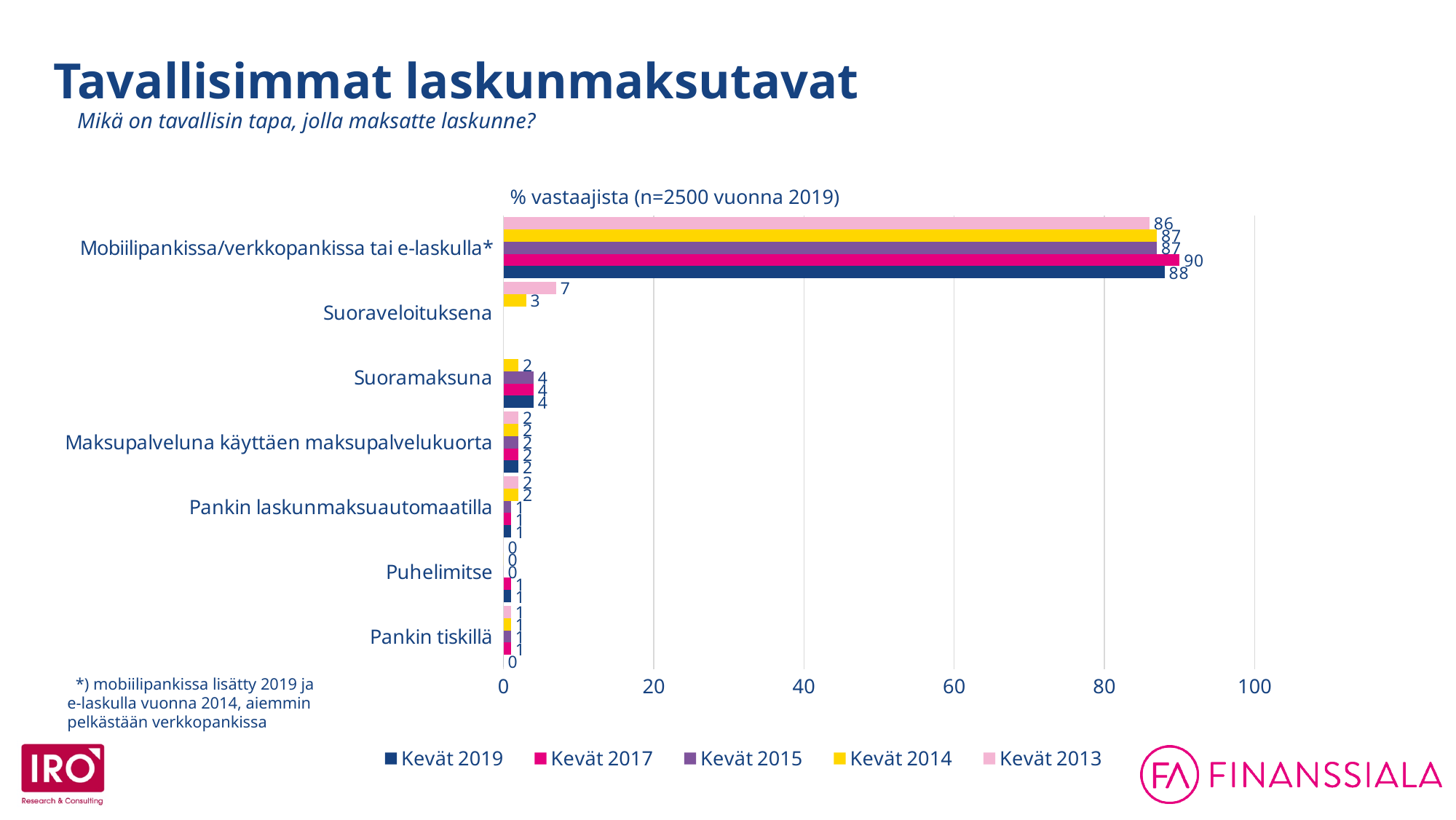
How many categories (payment methods) are shown on the chart? 7 What is the Kevät 2013 value for Suoraveloituksena? 7 Is the Kevät 2019 value for Mobiilipankissa/verkkopankissa tai e-laskulla* greater or less than 80? greater What is the Kevät 2017 value for Mobiilipankissa/verkkopankissa tai e-laskulla*? 90 What is the Kevät 2019 value for Mobiilipankissa/verkkopankissa tai e-laskulla*? 88 What is the chart's title above the plot area? % vastaajista (n=2500 vuonna 2019) What is the difference between the Kevät 2017 and Kevät 2013 values for Mobiilipankissa/verkkopankissa tai e-laskulla*? 4 How many series does the legend list? 5 Which category has the highest value in Kevät 2019? Mobiilipankissa/verkkopankissa tai e-laskulla* What is the Kevät 2014 value for Suoraveloituksena? 3 Which is larger for Suoramaksuna: the Kevät 2019 value or the Kevät 2014 value? Kevät 2019 What kind of chart is shown on the slide? bar chart